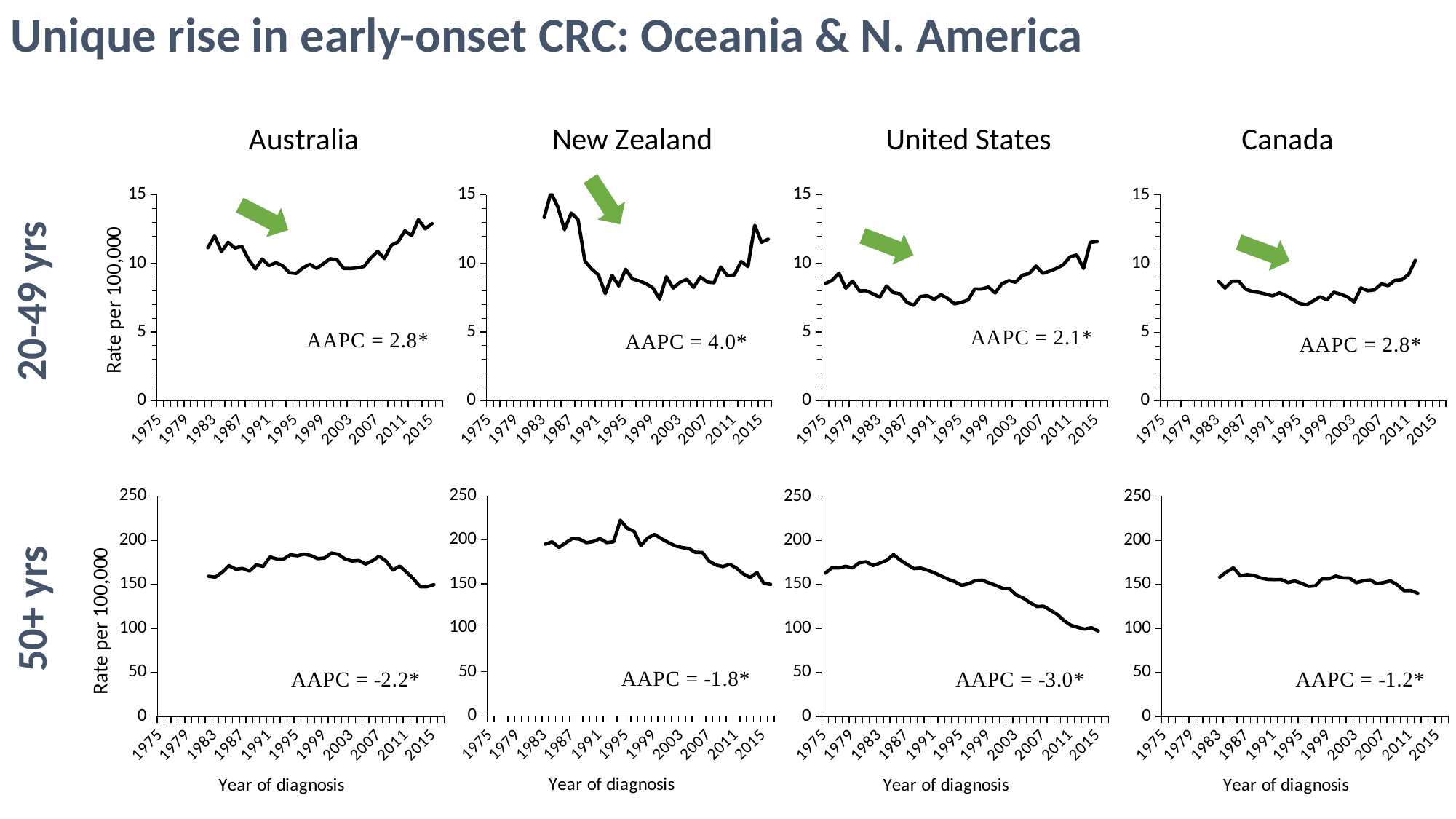
In the United States 50+ yrs chart, what is the AAPC value shown? -3.0* What kind of chart is the Australia 20-49 yrs chart? line chart In the United States 50+ yrs chart, do the values rise or fall from 1987 to 2015? fall In the United States 50+ yrs chart, is the value for 2015 greater or less than 150? less In the Australia 50+ yrs chart, is the value for 1999 greater or less than 150? greater In the Canada 20-49 yrs chart, is the value for 1997 greater or less than 10? less In the Canada 50+ yrs chart, what is the AAPC value shown? -1.2* In the New Zealand 20-49 yrs chart, what is the AAPC value shown? 4.0* What is the x-axis label shown under the charts? Year of diagnosis Among the 20-49 yrs charts, which has the higher AAPC: New Zealand or United States? New Zealand